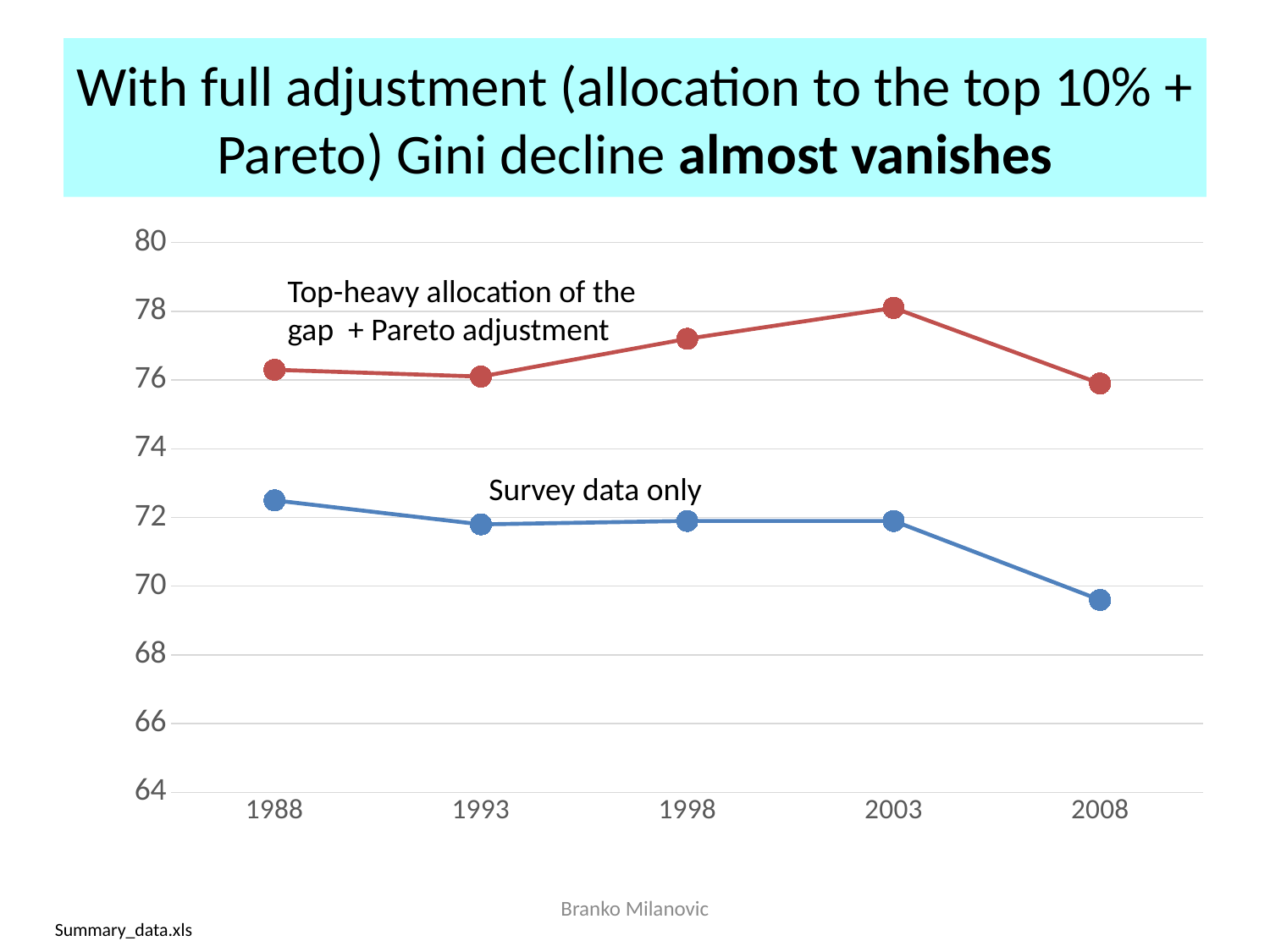
Is the 'Survey data only' value for 2008 greater or less than 70? less In which year does the 'Survey data only' series reach its highest value? 1988 Is the 'Top-heavy allocation of the gap + Pareto adjustment' value for 1998 greater or less than 76? greater In which year does the 'Top-heavy allocation of the gap + Pareto adjustment' series reach its highest value? 2003 In 2008, which series has the larger value: 'Survey data only' or 'Top-heavy allocation of the gap + Pareto adjustment'? Top-heavy allocation of the gap + Pareto adjustment Is the 'Survey data only' value for 1988 greater or less than 72? greater Does the 'Survey data only' series rise or fall between 2003 and 2008? Fall In which year does the 'Survey data only' series reach its lowest value? 2008 How many data series (lines) are plotted on the chart? 2 What kind of chart is shown on the slide? Line chart What colour is the 'Survey data only' line? Blue How many years are plotted along the x axis? 5